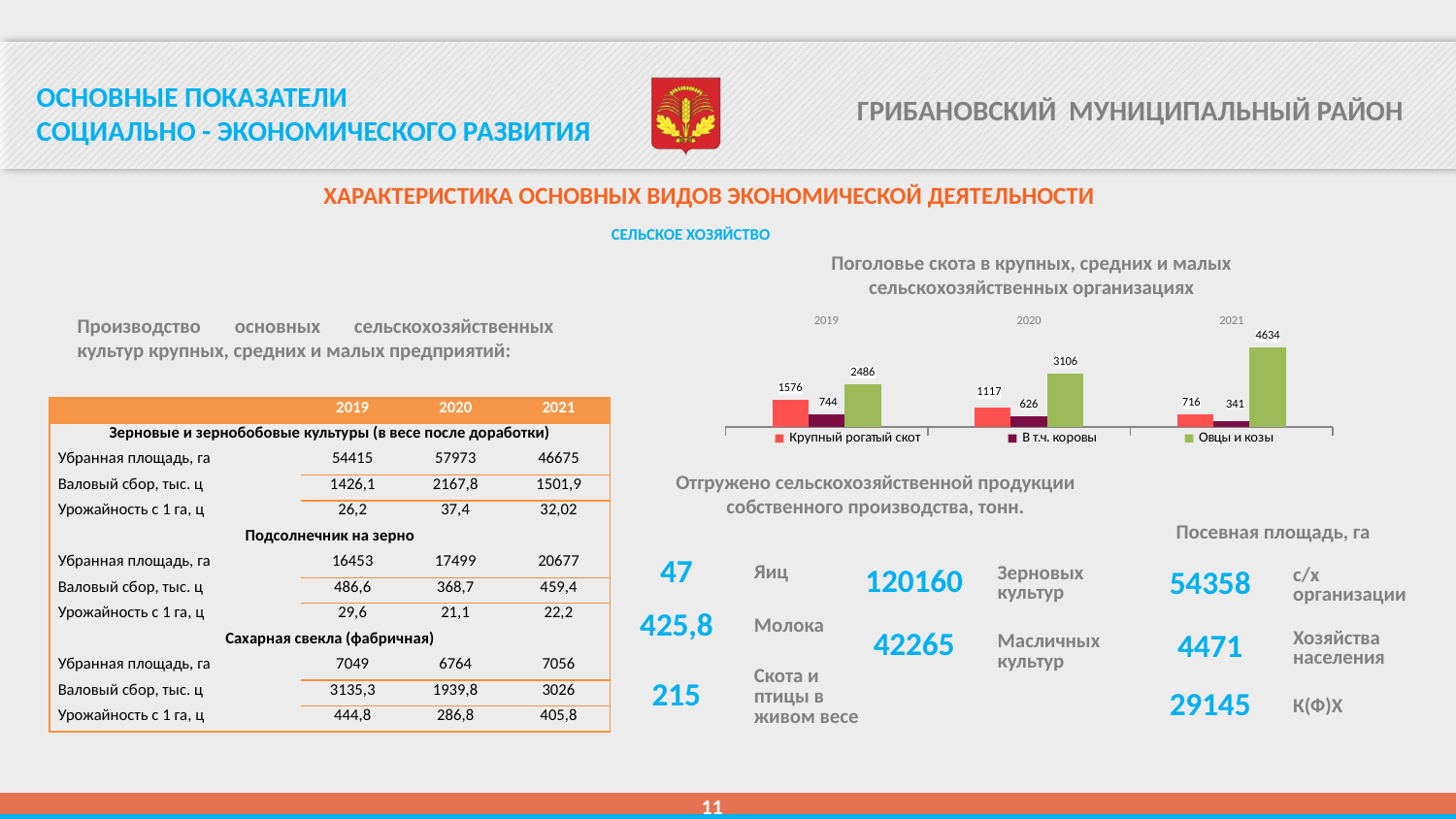
In the livestock chart, what is the value for Крупный рогатый скот in 2019? 1576 What type of chart is used to show the livestock headcount (Поголовье скота) on the slide? bar chart In the livestock chart, what is the value for В т.ч. коровы in 2020? 626 How many year groups are shown on the x axis of the livestock chart? 3 In the livestock chart, what is the value for Овцы и козы in 2021? 4634 In the livestock chart, which is larger in 2019: Крупный рогатый скот or Овцы и козы? Овцы и козы In the livestock chart, which year has the highest value for Овцы и козы? 2021 In the livestock chart, do the values for Крупный рогатый скот rise or fall from 2019 to 2021? fall In the livestock chart, which year has the lowest value for Крупный рогатый скот? 2021 In the livestock chart, which colour represents Овцы и козы? green How many series does the legend of the livestock chart list? 3 In the livestock chart, what is the difference between Овцы и козы in 2021 and in 2020? 1528